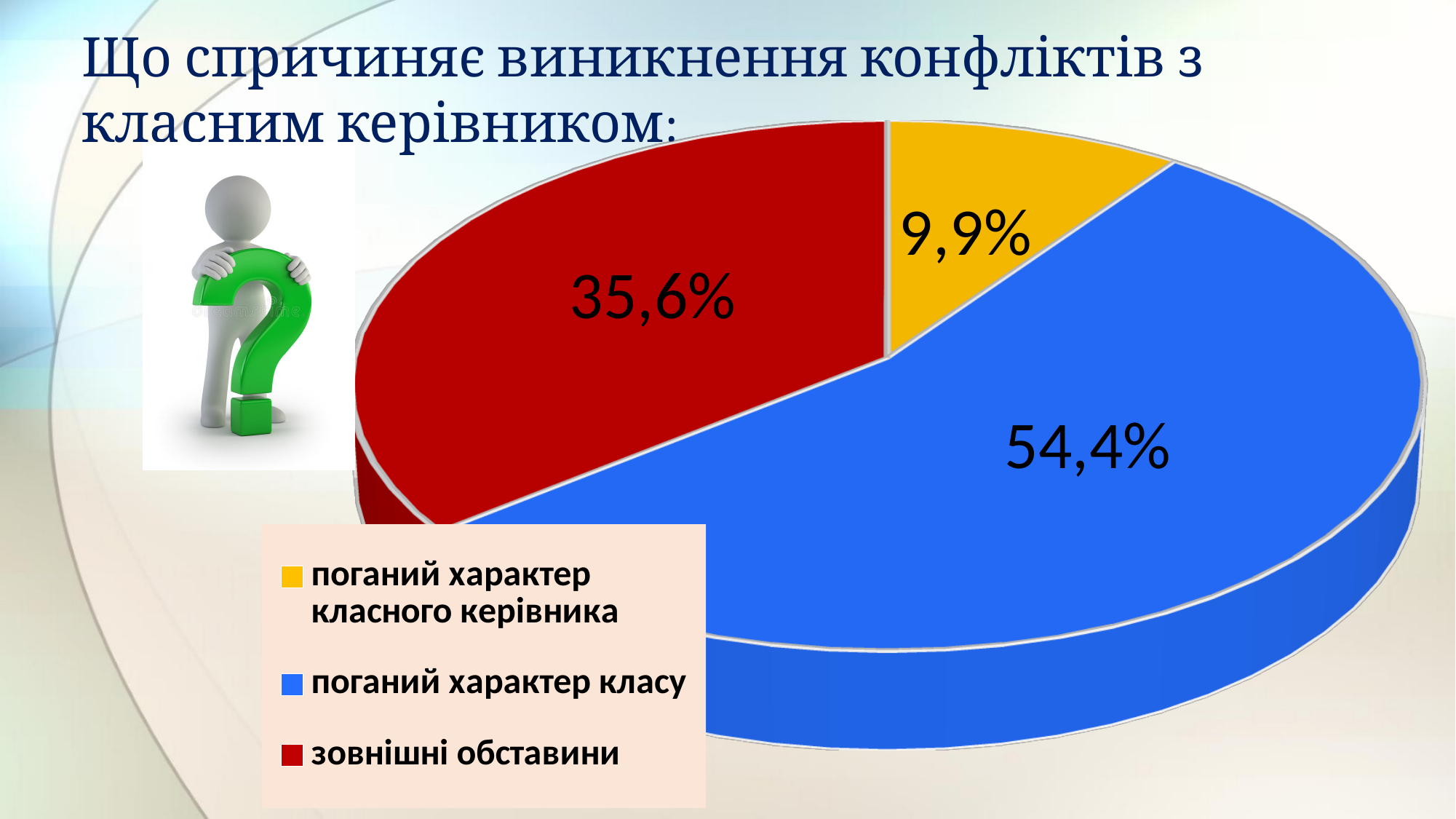
What percentage is shown for 'поганий характер класу'? 54,4% Which category does the red slice represent? зовнішні обставини What is the difference between the shares for 'поганий характер класу' and 'зовнішні обставини'? 18,8% Which is larger: the share for 'зовнішні обставини' or for 'поганий характер класного керівника'? зовнішні обставини What is the difference between the shares for 'зовнішні обставини' and 'поганий характер класного керівника'? 25,7% What colour is the slice for 'поганий характер класу'? blue How many slices does the pie chart have? 3 What percentage is shown for 'поганий характер класного керівника'? 9,9% Which category has the smallest share of the pie? поганий характер класного керівника What percentage is shown for 'зовнішні обставини'? 35,6% What kind of chart is shown on the slide? pie chart Which category has the largest share of the pie? поганий характер класу